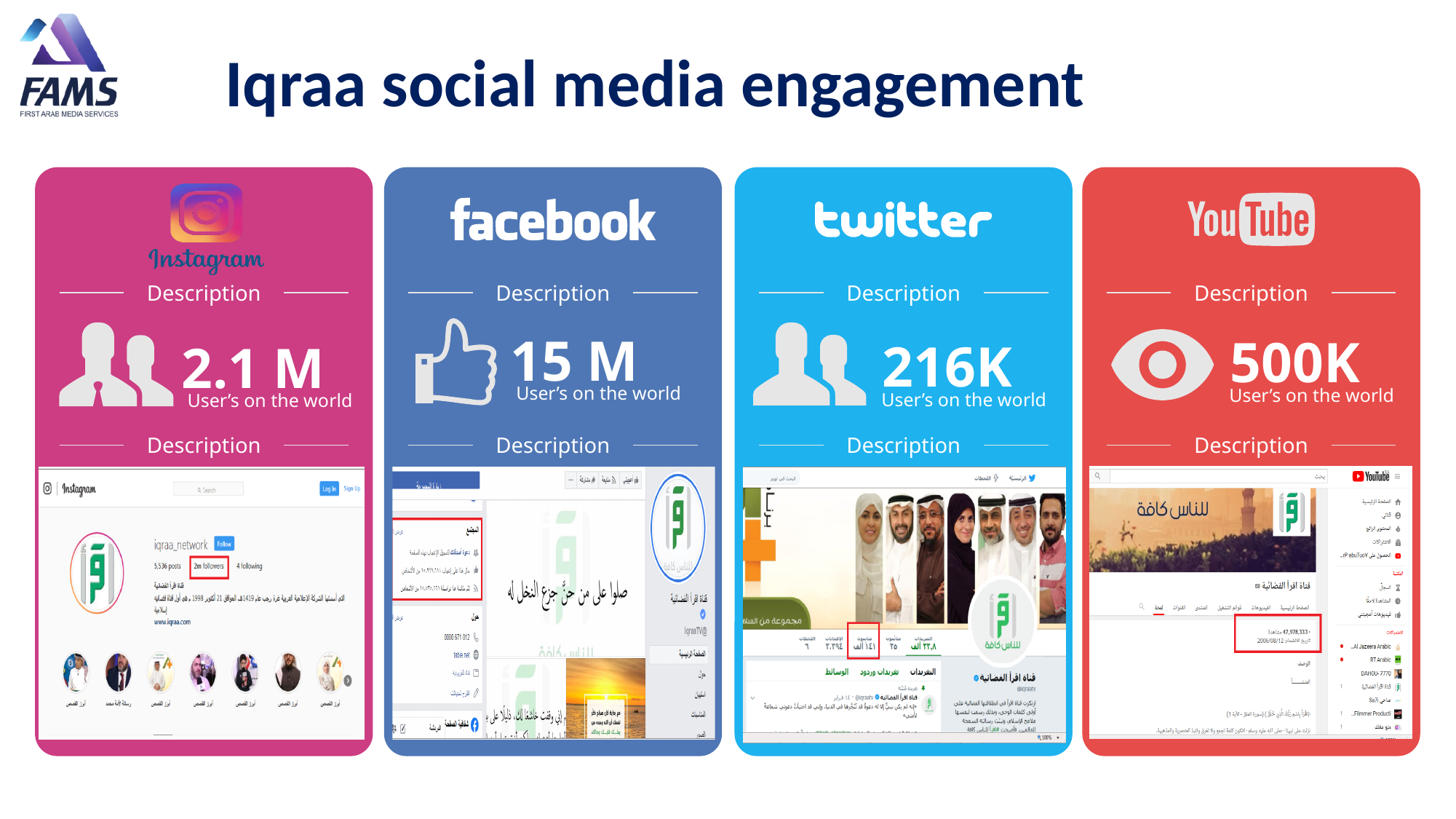
What is the number of users shown for YouTube? 500K What is the number of users shown for Twitter? 216K Which has more users shown, YouTube or Twitter? YouTube How many social media platforms are shown on the slide? 4 Which has more users shown, Instagram or YouTube? Instagram What is the title of the slide? Iqraa social media engagement Which platform's panel is coloured red? YouTube What is the difference between the YouTube and Twitter user figures? 284K Which platform has the highest number of users shown? Facebook What is the number of users shown for Facebook? 15 M What is the number of users shown for Instagram? 2.1 M Which platform has the lowest number of users shown? Twitter